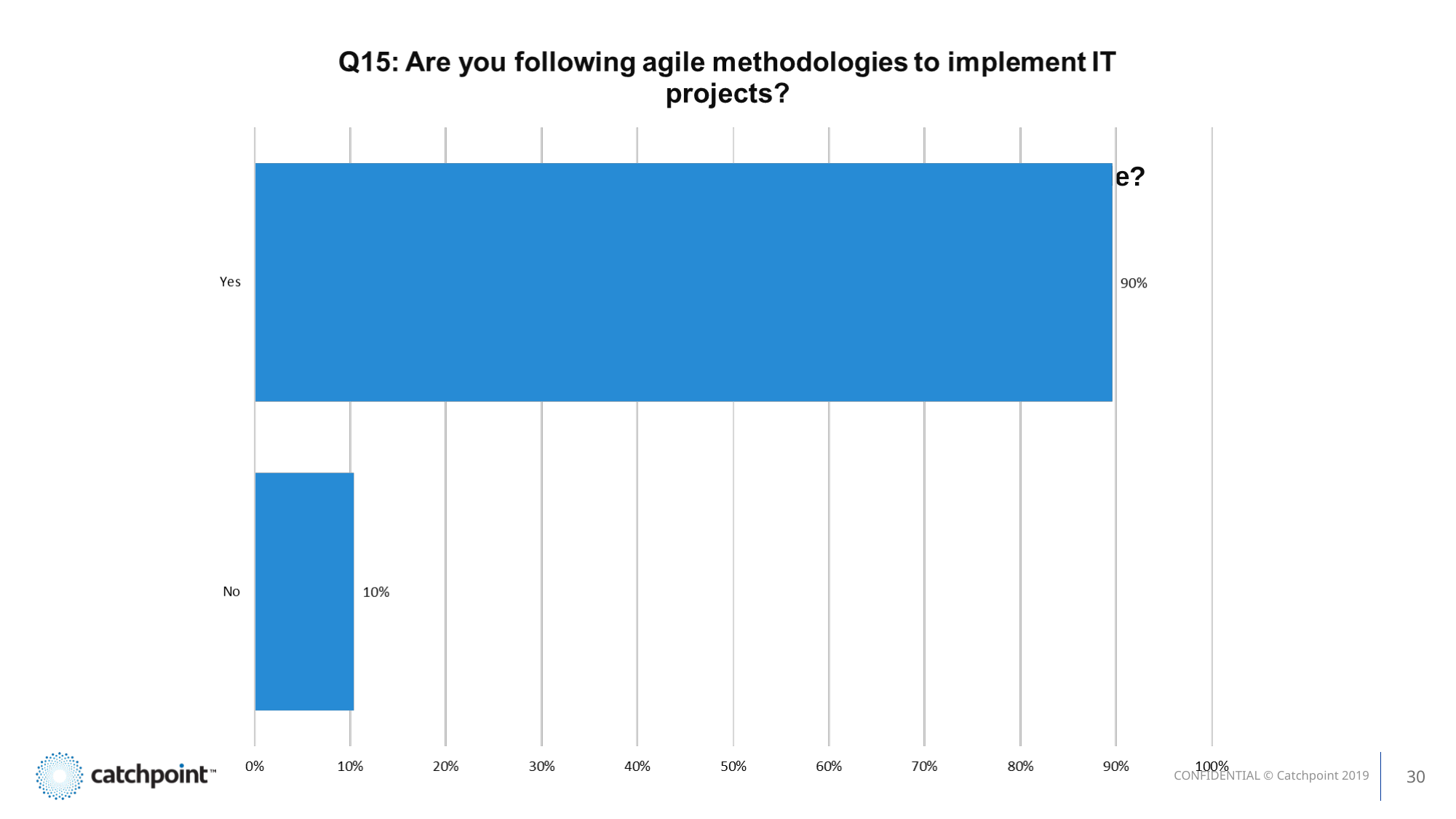
What is the difference between the "Yes" and "No" percentages? 80% What kind of chart is shown on the slide? Bar chart Which response category has the highest value? Yes Is the value for "No" greater or less than 20%? less What is the title of the chart? Q15: Are you following agile methodologies to implement IT projects? Which response category has the lowest value? No Is the value for "Yes" greater or less than 50%? greater How many response categories are shown in the chart? 2 What percentage of respondents answered "No" to following agile methodologies to implement IT projects? 10% Which is larger, the value for "Yes" or the value for "No"? Yes What percentage of respondents answered "Yes" to following agile methodologies to implement IT projects? 90% What is the maximum value shown on the horizontal axis? 100%